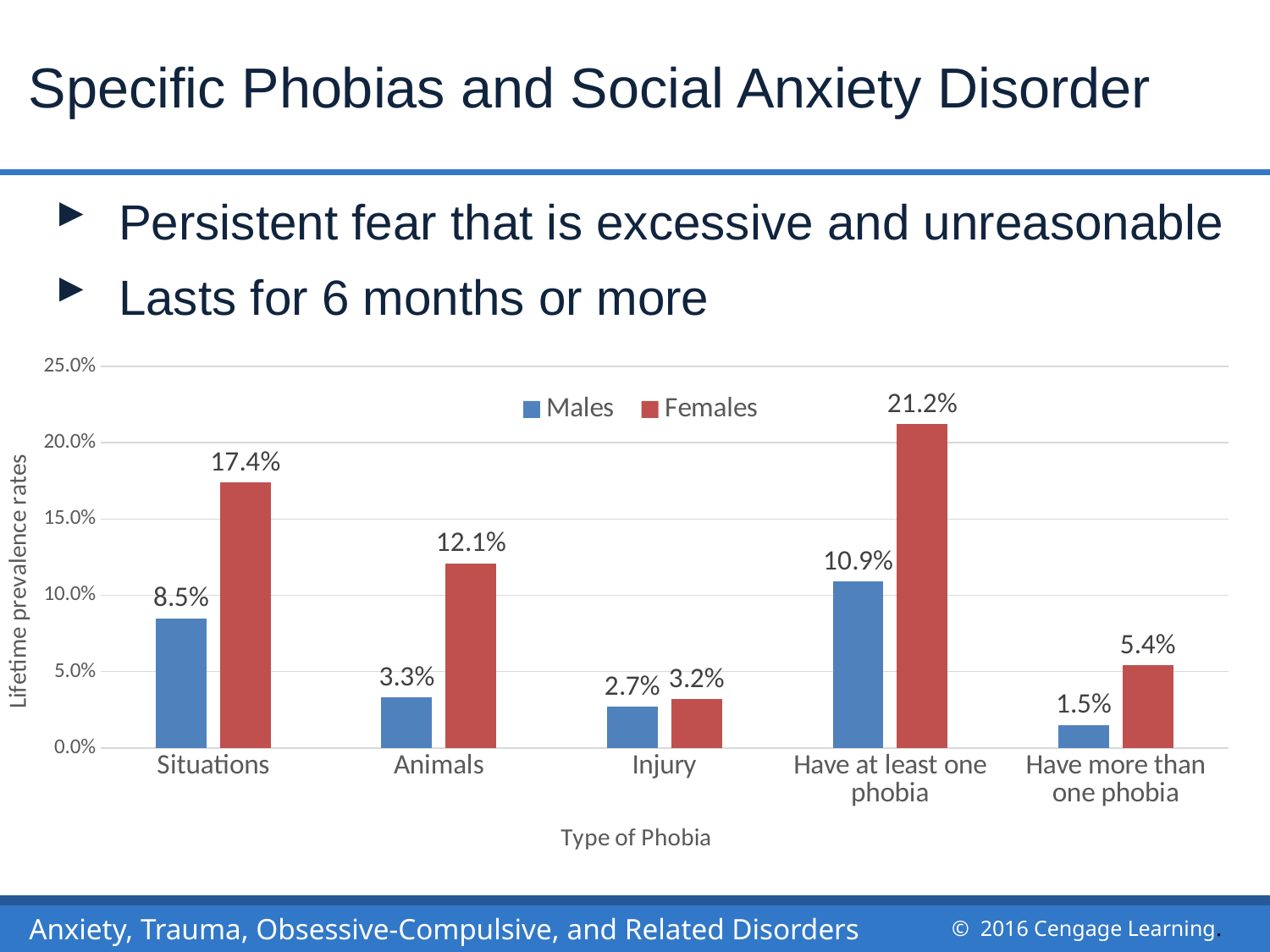
Which is larger, the Males value for Situations or the Males value for Have at least one phobia? Have at least one phobia What is the difference between the Females and Males values for Have at least one phobia? 10.3% What kind of chart is shown on the slide? Bar chart What is the difference between the Females and Males values for Situations? 8.9% What is the lifetime prevalence rate for Females for Have more than one phobia? 5.4% What is the lifetime prevalence rate for Females for Situations? 17.4% Which type of phobia has the lowest Males value? Have more than one phobia Is the Females value for Animals greater or less than 10.0%? greater How many types of phobia are shown on the x axis? 5 How many series does the legend list? 2 What is the lifetime prevalence rate for Males for Animals? 3.3% Which type of phobia has the highest Females value? Have at least one phobia